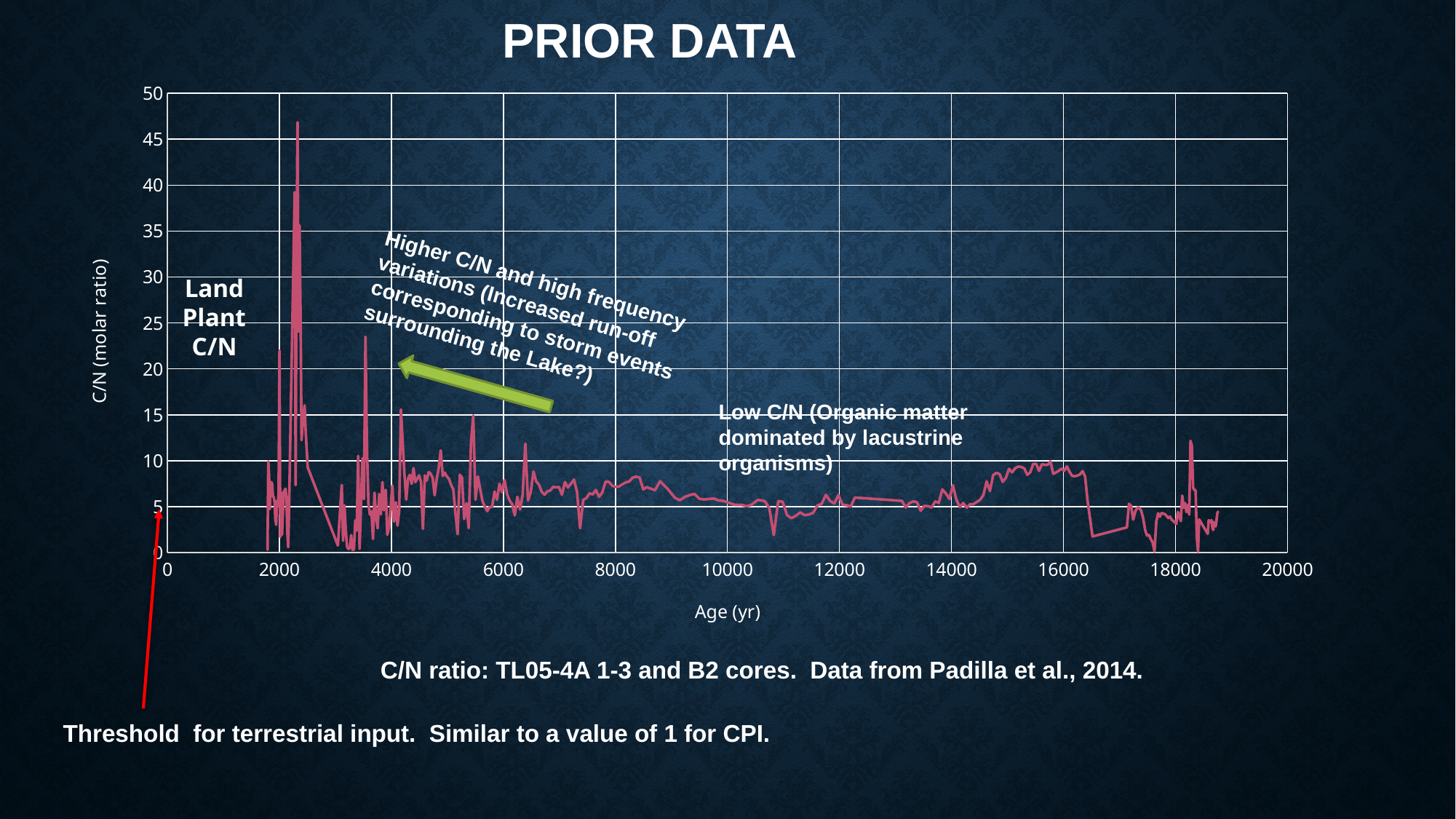
What kind of chart is shown on the slide? line chart What is the label of the vertical axis of the chart? C/N (molar ratio) Which is larger: the C/N ratio peak near 2300 yr or the peak near 3500 yr? the peak near 2300 yr Does the highest peak of the C/N ratio occur before or after an age of 10000 yr? before What is the title of the slide containing the chart? PRIOR DATA Is the C/N ratio at an age of about 16000 yr greater or less than 5? greater Is the highest peak of the C/N ratio greater or less than 40? greater Between ages of about 14000 yr and 16000 yr, does the C/N ratio generally rise or fall? rise Is the C/N ratio at an age of about 10000 yr greater or less than 10? less Between ages of about 2300 yr and 3000 yr, does the C/N ratio rise or fall? fall